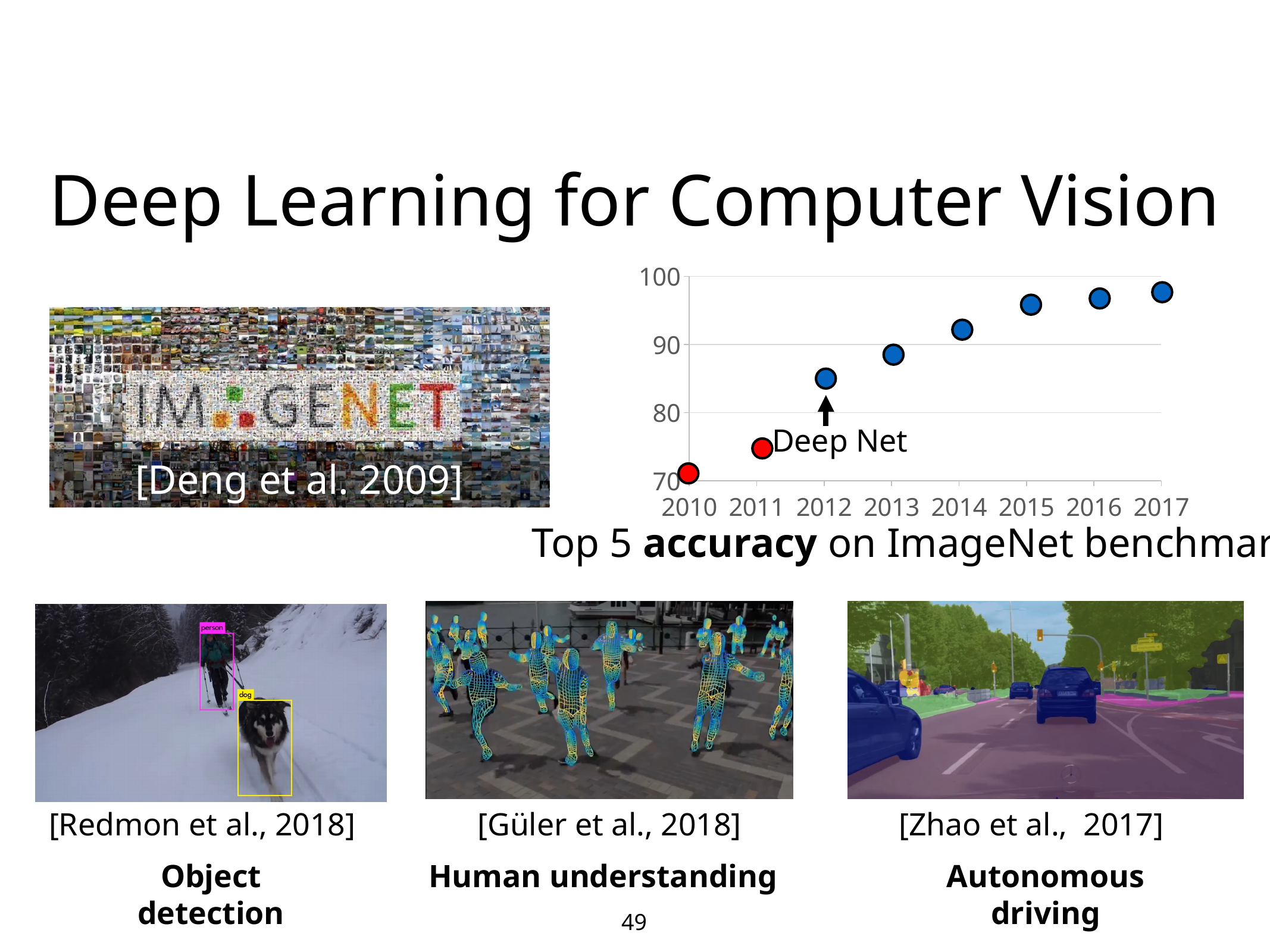
Which is larger, the value for 2012 or the value for 2011? 2012 How many points in the chart are coloured red? 2 Do the values in the chart rise or fall from 2010 to 2017? rise What kind of chart is shown on the slide? scatter chart How many data points are plotted in the chart? 8 Which year has the highest value in the chart? 2017 Is the value for 2013 greater or less than 90? less Which year has the lowest value in the chart? 2010 Which year is labelled with the annotation "Deep Net" in the chart? 2012 Is the value for 2011 greater or less than 80? less Is the value for 2012 greater or less than 80? greater